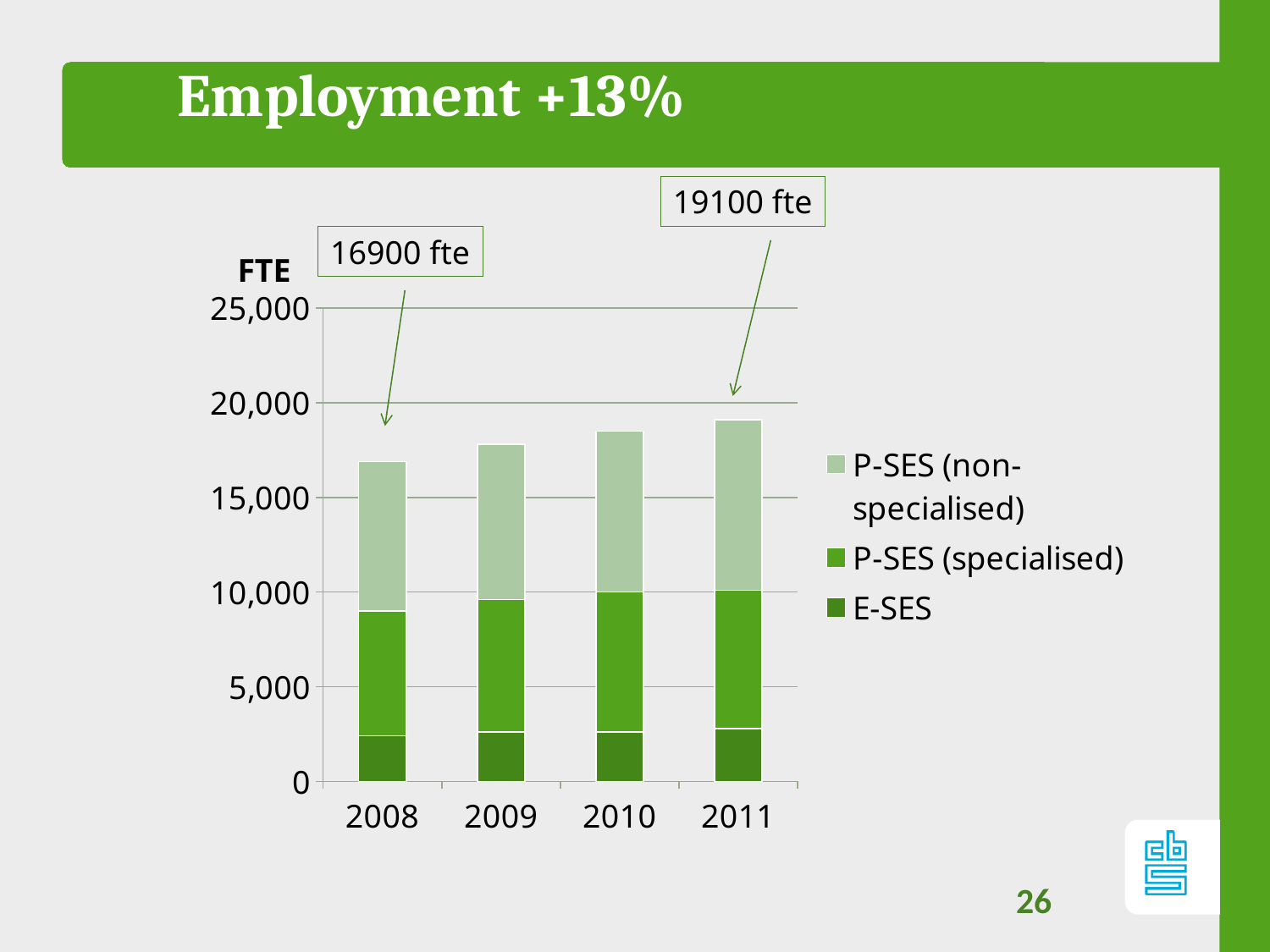
How many series does the legend list? 3 What kind of chart is shown on the slide? bar chart Which year has the lowest total bar? 2008 Is the E-SES value for 2008 greater or less than 5,000? less How many years are shown on the x axis of the chart? 4 What is the difference between the total employment in 2011 and in 2008? 2200 fte Do the total bar heights rise or fall from 2008 to 2011? rise What is the total employment shown for 2011? 19100 fte What is the label on the vertical axis of the chart? FTE What is the total employment shown for 2008? 16900 fte Is the total value for 2010 greater or less than 20,000? less Which year has the highest total bar? 2011